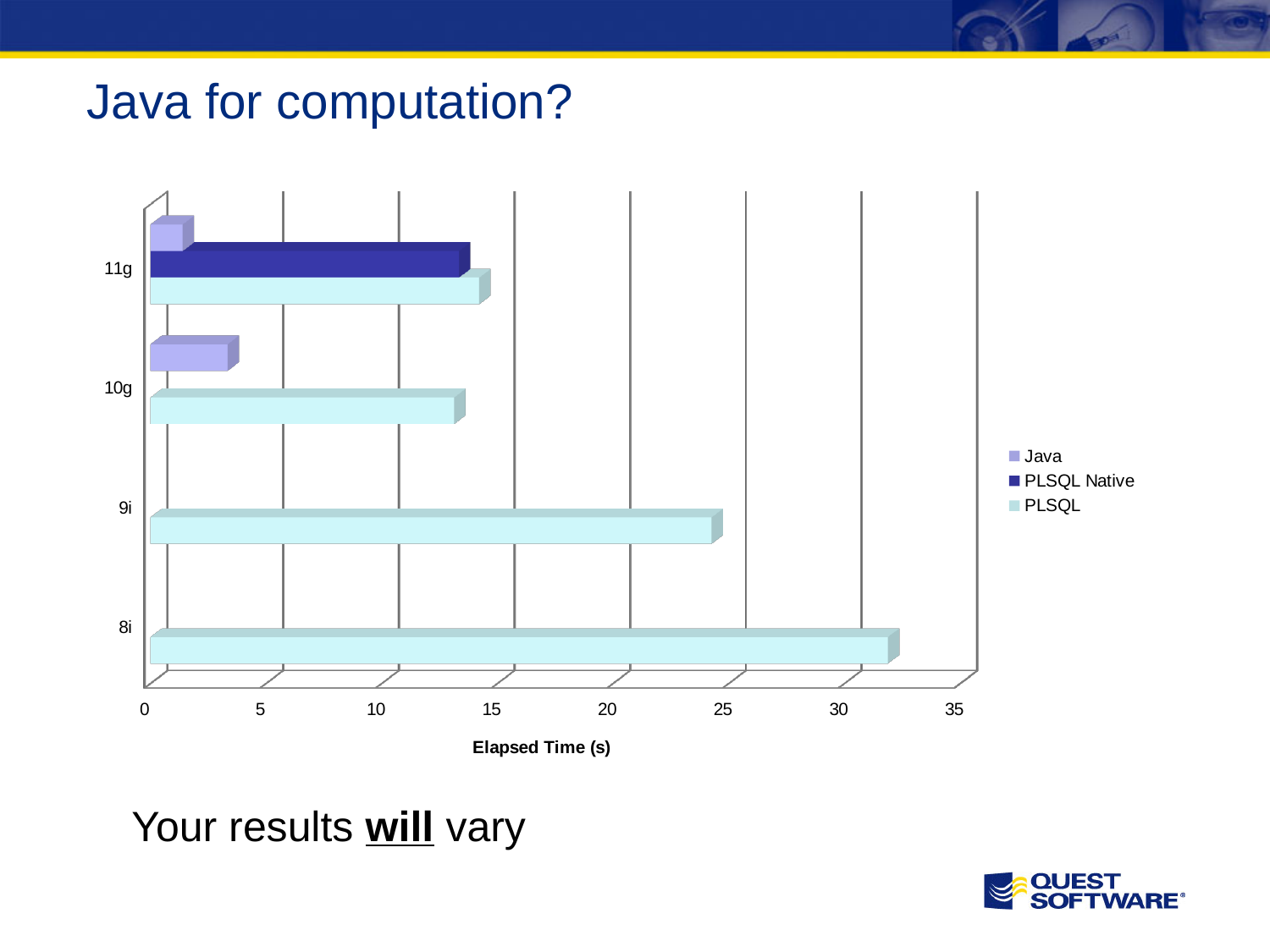
What is the title of the horizontal axis? Elapsed Time (s) Which series are listed in the legend? Java, PLSQL Native, PLSQL For which version is the PLSQL elapsed time lowest? 10g For which version is the PLSQL elapsed time highest? 8i Which has the larger elapsed time for 10g, Java or PLSQL? PLSQL Is the PLSQL elapsed time for 9i greater or less than 20? greater Is the Java elapsed time for 10g greater or less than 5? less Is the PLSQL elapsed time for 8i greater or less than 30? greater Does the PLSQL elapsed time rise or fall as the version goes from 8i to 10g? fall What kind of chart is shown on the slide? bar chart How many database version categories are shown on the chart? 4 How many series does the legend list? 3